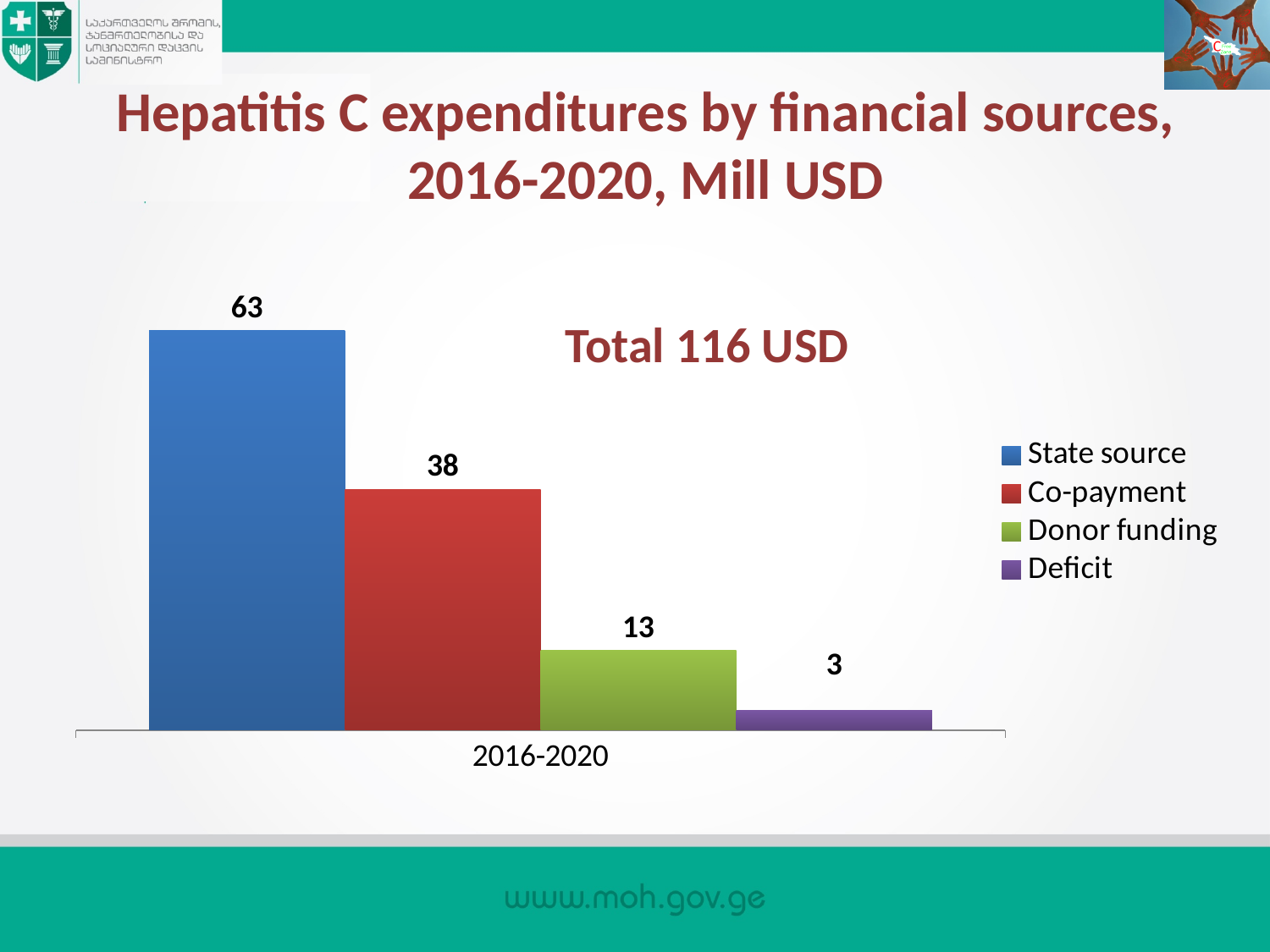
Which series has the highest value? State source What is the value for Deficit? 3 What is the difference between State source and Co-payment? 25 What is the value for State source? 63 What kind of chart is shown? Bar chart What is the value for Co-payment? 38 What is the difference between Donor funding and Deficit? 10 Which series has the lowest value? Deficit How many series does the legend list? 4 Which is larger, Co-payment or Donor funding? Co-payment What total is stated on the slide next to the chart? Total 116 USD What is the value for Donor funding? 13